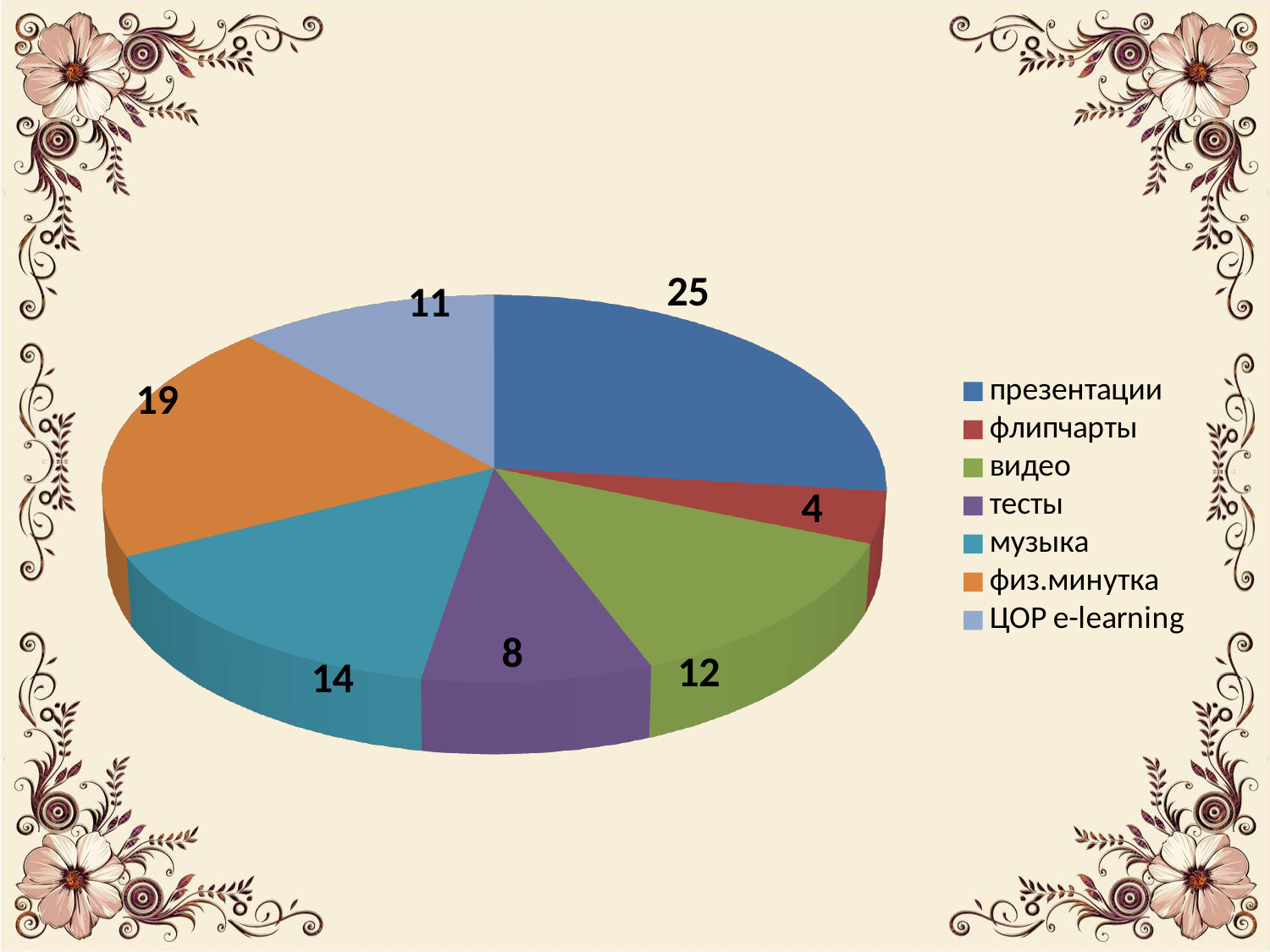
What is the difference between the values for музыка and тесты? 6 What is the value for флипчарты? 4 Which category has the largest slice? презентации What type of chart is shown on the slide? pie chart What colour is the slice for тесты? purple What is the value for презентации? 25 How many categories does the pie chart have? 7 What is the value for физ.минутка? 19 What is the value for ЦОР e-learning? 11 What is the difference between the values for презентации and физ.минутка? 6 Which category has the smallest slice? флипчарты Which is larger, видео or ЦОР e-learning? видео